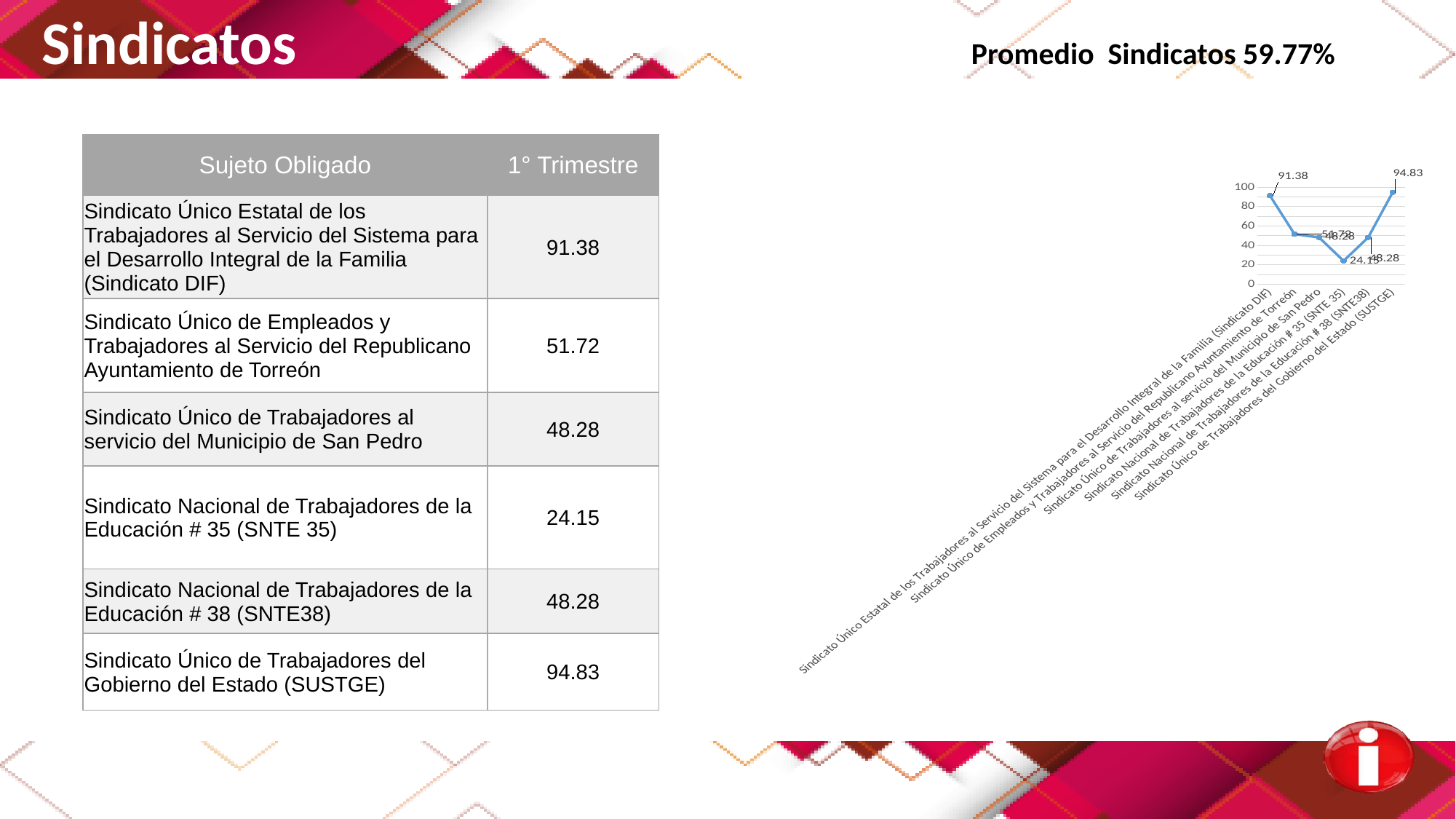
What kind of chart is shown on the slide? line chart What is the highest value shown on the vertical axis of the line chart? 100 How many data points are plotted on the line chart? 6 What is the value plotted for Sindicato Único Estatal de los Trabajadores al Servicio del Sistema para el Desarrollo Integral de la Familia (Sindicato DIF)? 91.38 What is the difference between the values for SUSTGE and SNTE 35 on the line chart? 70.68 Which category has the highest value on the line chart? Sindicato Único de Trabajadores del Gobierno del Estado (SUSTGE) Which category has the lowest value on the line chart? Sindicato Nacional de Trabajadores de la Educación # 35 (SNTE 35) What is the value plotted for Sindicato Nacional de Trabajadores de la Educación # 35 (SNTE 35)? 24.15 What is the value plotted for Sindicato Único de Trabajadores del Gobierno del Estado (SUSTGE)? 94.83 Is the value for Sindicato Nacional de Trabajadores de la Educación # 35 (SNTE 35) greater or less than 40? less Which is larger on the line chart: the value for Sindicato DIF or the value for SUSTGE? SUSTGE Is the value for Sindicato Único de Empleados y Trabajadores al Servicio del Republicano Ayuntamiento de Torreón greater or less than 80? less